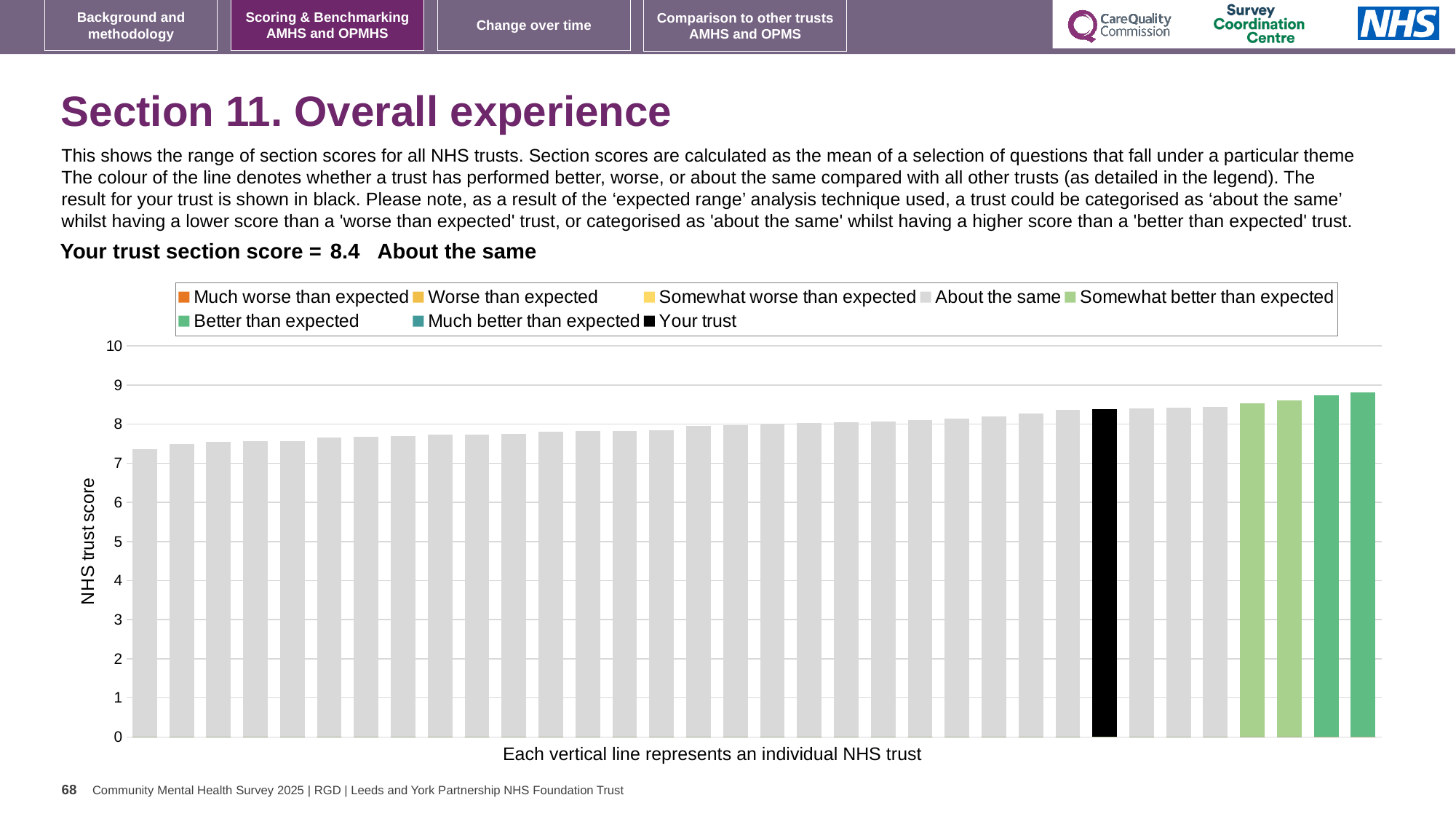
What is the section score for your trust shown on the slide? 8.4 What colour is the bar representing your trust? black How many entries does the chart legend list? 8 Do the bar values rise or fall from left to right along the x axis? rise Which category is your trust's section score placed in? About the same What kind of chart is shown on the slide? bar chart How many bars are coloured green (better than expected categories) in the chart? 4 How many bars are coloured black in the chart? 1 Is the value of the leftmost (shortest) bar greater or less than 8? less Is the value of the leftmost (shortest) bar greater or less than 7? greater Is the value of the tallest bar greater or less than 8? greater What is the label on the vertical axis of the chart? NHS trust score